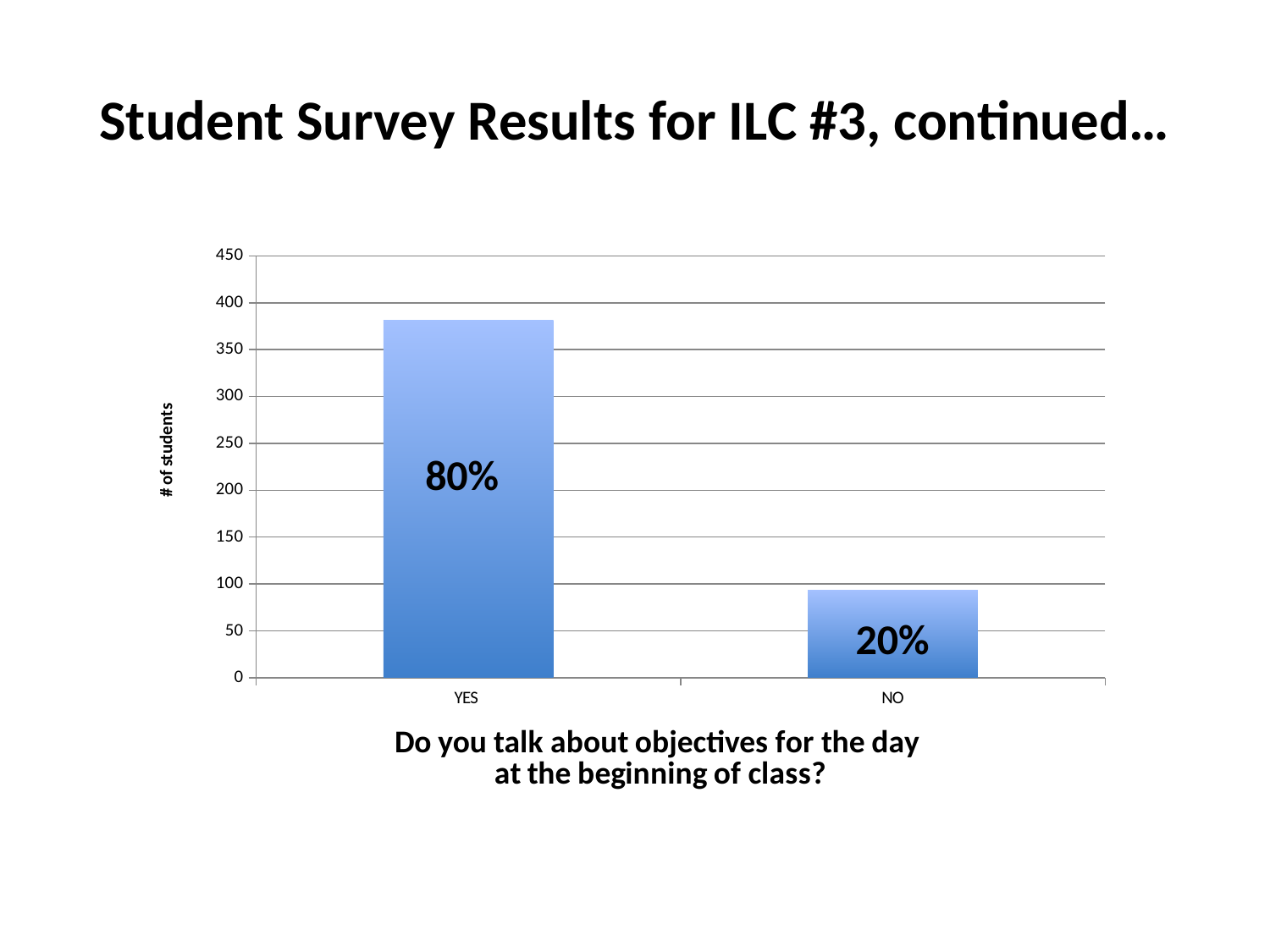
Is the value for YES greater or less than 400? less Is the value for NO greater or less than 100? less Which bar is taller, YES or NO? YES Is the value for YES greater or less than 350? greater Which category has the lowest bar? NO What is the label on the vertical axis of the chart? # of students Which category has the highest bar? YES What is the difference in percentage points between the YES and NO labels? 60 What kind of chart is shown on the slide? bar chart How many categories are shown on the x axis of the chart? 2 What percentage label is shown on the YES bar? 80% What percentage label is shown on the NO bar? 20%